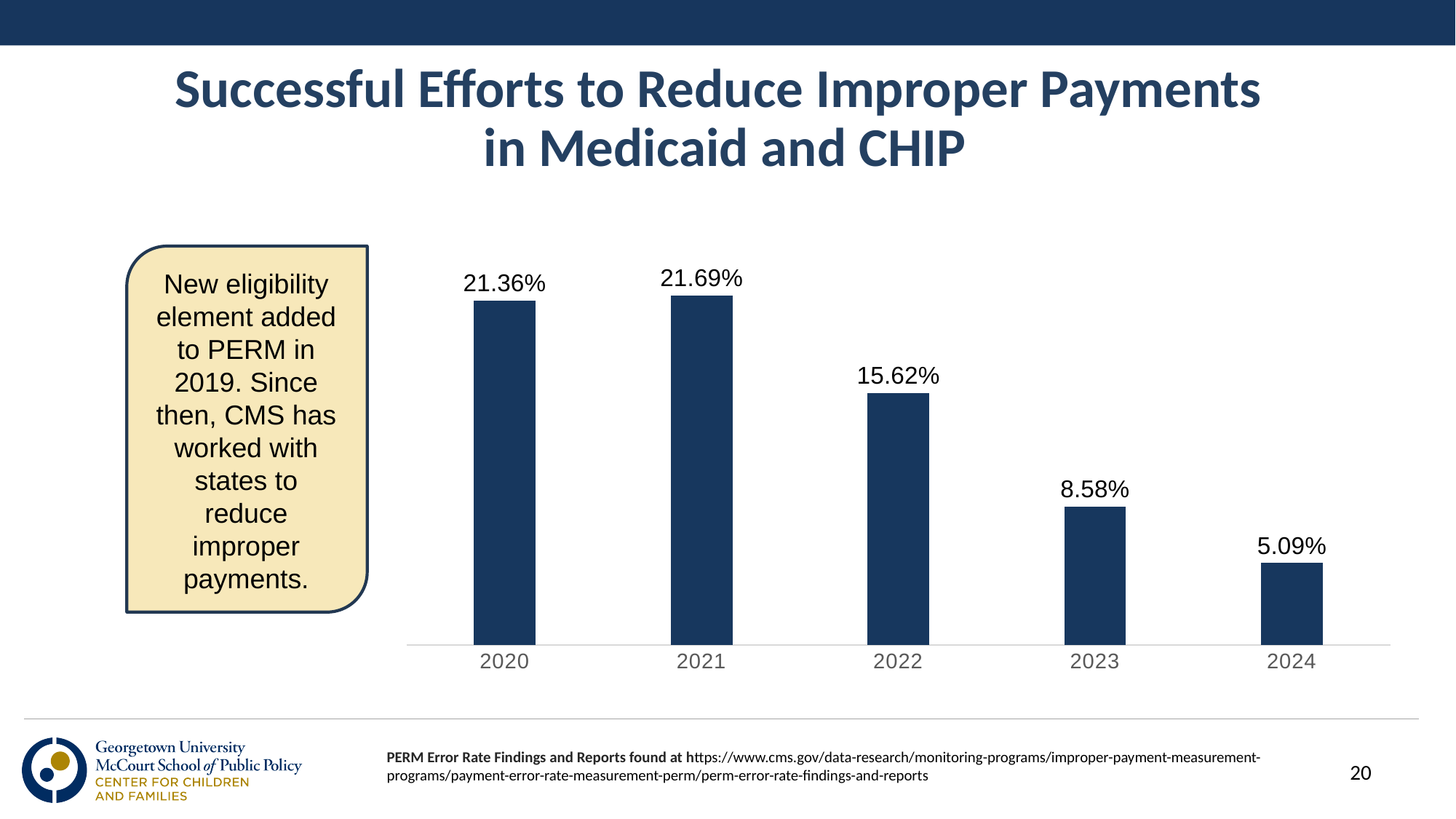
What is the difference between the values for 2022 and 2023? 7.04% What is the value shown for 2022? 15.62% Which year has the lowest value? 2024 How many years are shown on the chart? 5 Which year has the highest value? 2021 What is the value shown for 2024? 5.09% What is the title of the slide containing the chart? Successful Efforts to Reduce Improper Payments in Medicaid and CHIP Do the values generally rise or fall from 2021 to 2024? fall Which is larger, the value for 2022 or the value for 2023? 2022 What kind of chart is shown on the slide? bar chart What is the difference between the values for 2021 and 2020? 0.33% What is the value shown for 2020? 21.36%